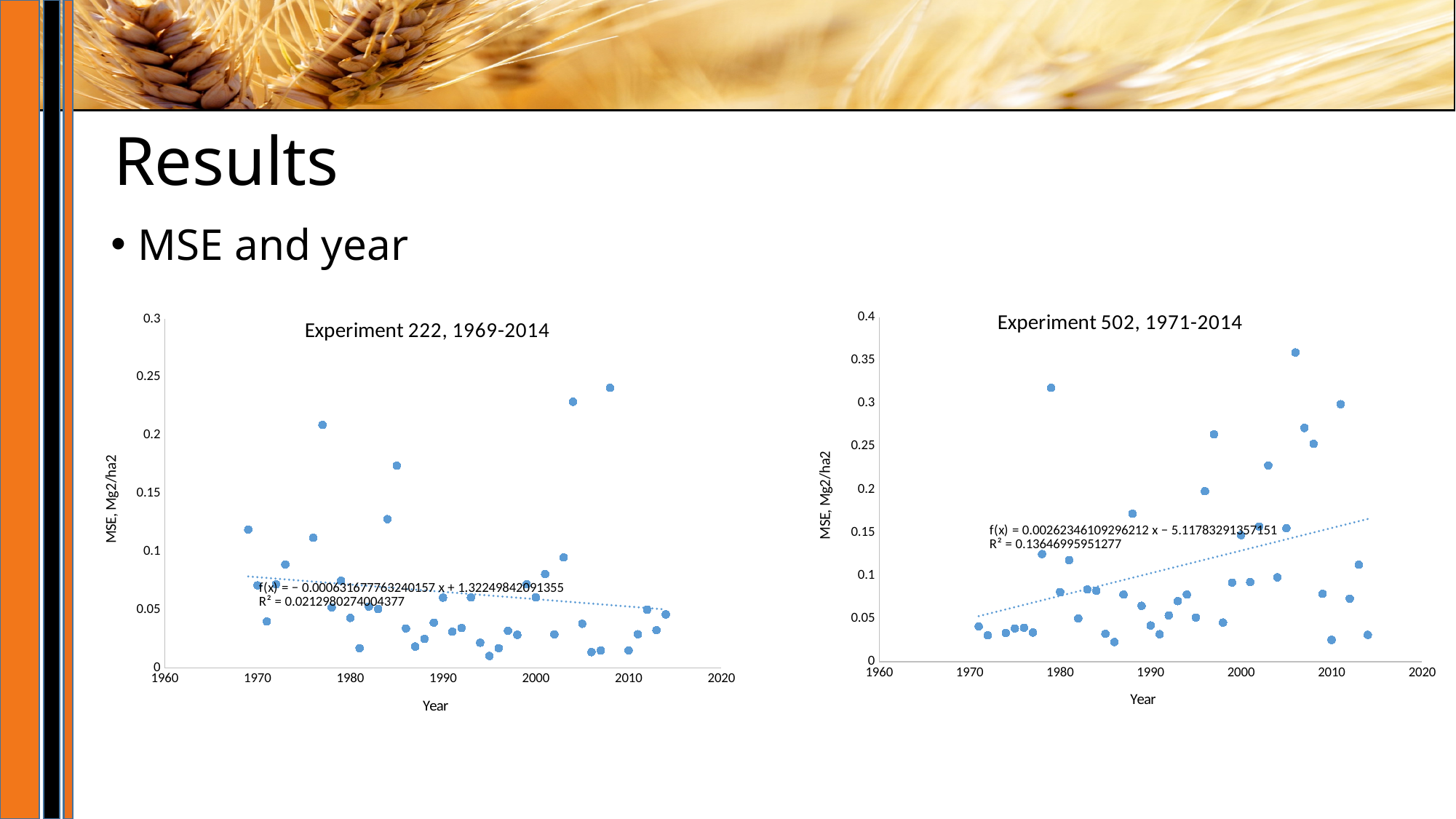
In the Experiment 502, 1971-2014 chart, is the MSE value for 1979 greater or less than 0.25? greater In the Experiment 502, 1971-2014 chart, does the fitted trendline rise or fall as year increases? rise In the Experiment 222, 1969-2014 chart, is the highest plotted MSE value greater or less than 0.2? greater In the Experiment 222, 1969-2014 chart, what is the R² value printed for the trendline? 0.0212980274004377 What is the y-axis label on the Experiment 222, 1969-2014 chart? MSE, Mg2/ha2 In the Experiment 222, 1969-2014 chart, is the MSE value for 1977 greater or less than 0.15? greater What kind of chart is the Experiment 222, 1969-2014 chart? scatter chart Which chart has the larger R² value, Experiment 222 or Experiment 502? Experiment 502 In the Experiment 222, 1969-2014 chart, does the fitted trendline rise or fall as year increases? fall What is the title of the chart on the right side of the slide? Experiment 502, 1971-2014 In the Experiment 502, 1971-2014 chart, what is the R² value printed for the trendline? 0.13646995951277